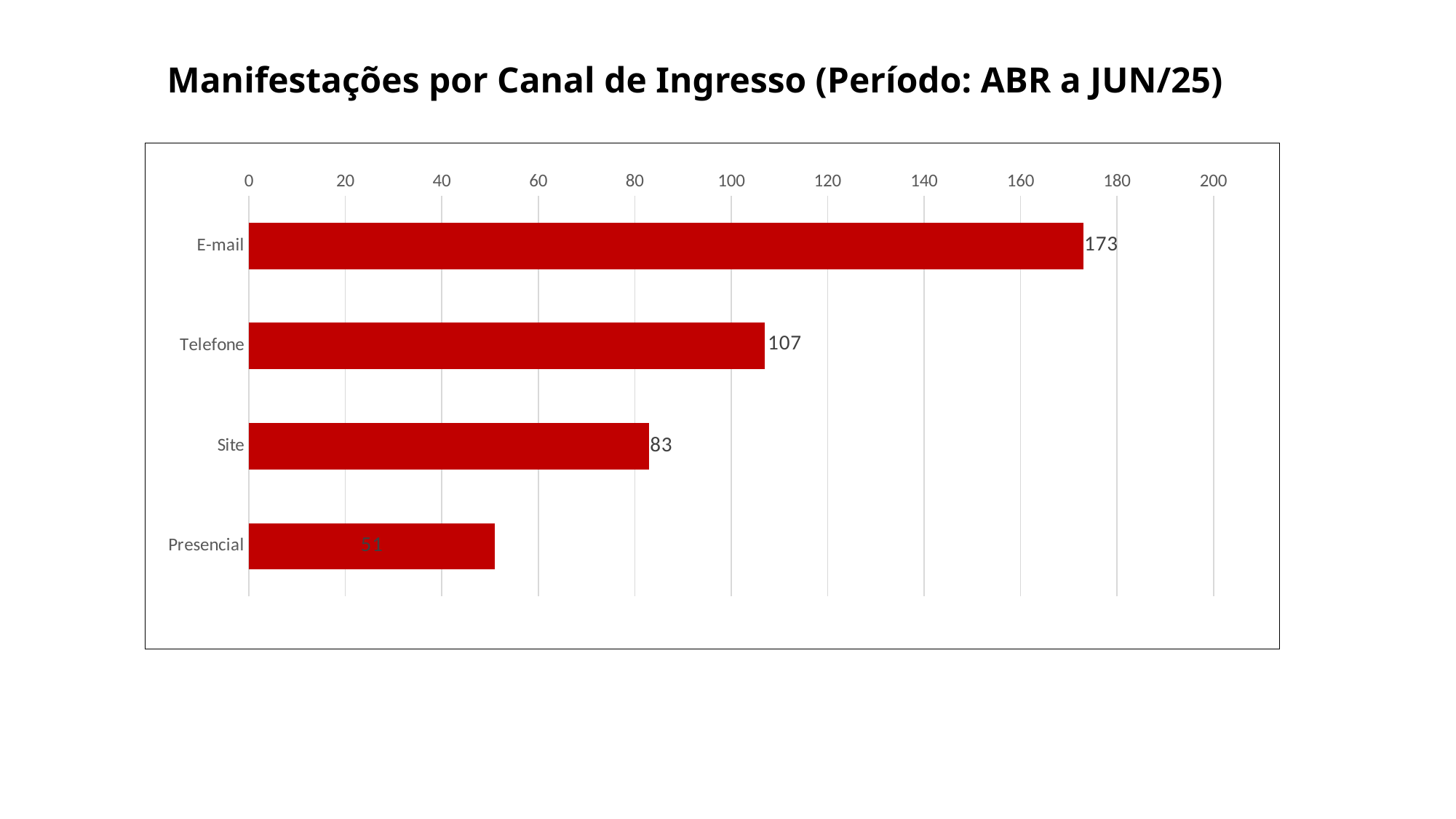
What is the value for Telefone? 107 What is the value for E-mail? 173 How many channels (categories) are shown in the chart? 4 What kind of chart is shown on the slide? Bar chart Is the value for Site greater or less than 100? less What is the value for Site? 83 Which is larger, the value for Telefone or the value for Site? Telefone What is the difference between the values for E-mail and Telefone? 66 What is the value for Presencial? 51 What is the difference between the values for Site and Presencial? 32 Which channel has the highest number of manifestações? E-mail Which channel has the lowest number of manifestações? Presencial